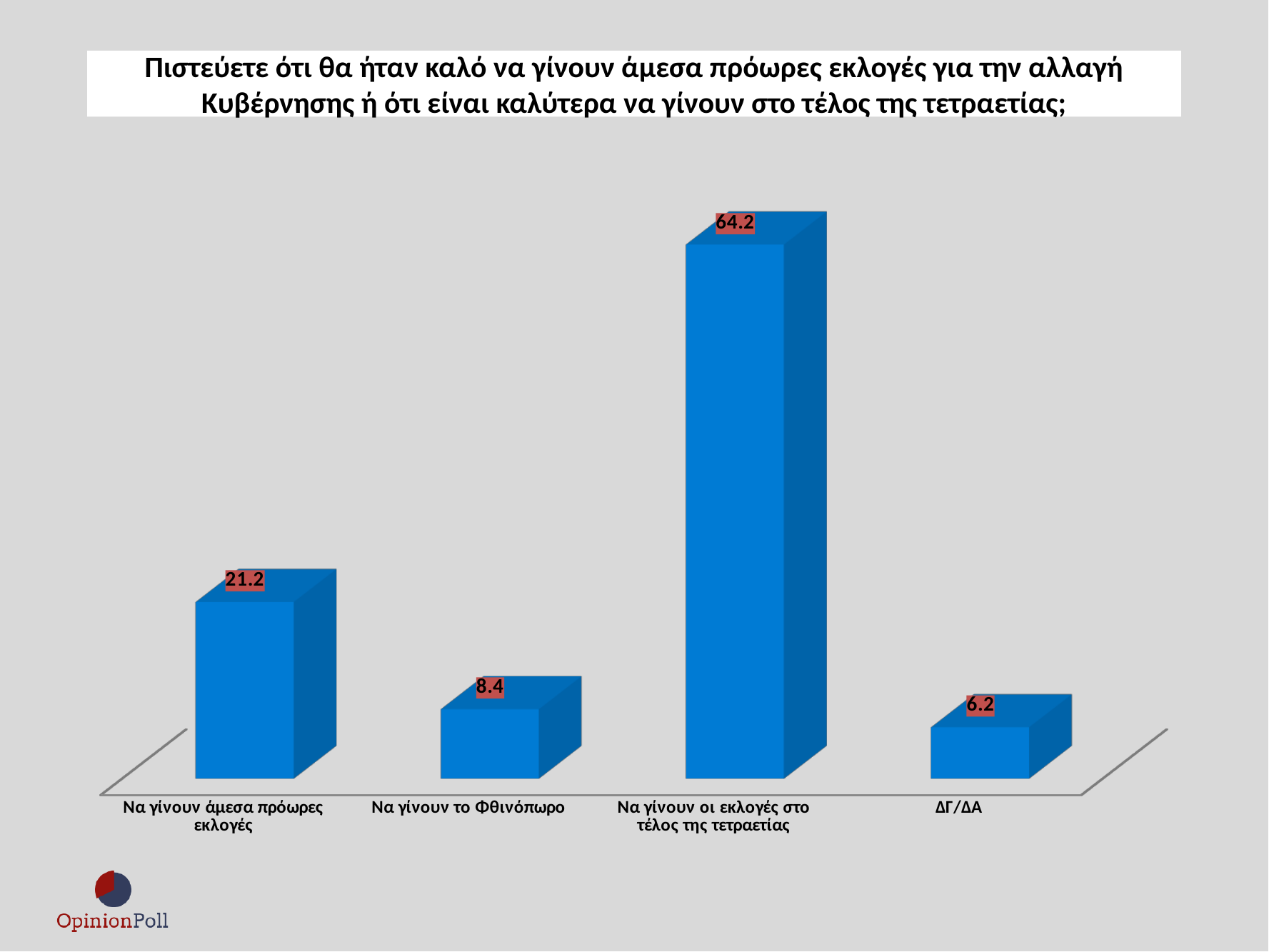
How many categories are shown in the chart? 4 What kind of chart is shown on the slide? Bar chart What colour are the bars in the chart? Blue What is the value for "ΔΓ/ΔΑ"? 6.2 What is the value for "Να γίνουν άμεσα πρόωρες εκλογές"? 21.2 Which category has the lowest value? ΔΓ/ΔΑ Which is larger, the value for "Να γίνουν άμεσα πρόωρες εκλογές" or the value for "Να γίνουν το Φθινόπωρο"? Να γίνουν άμεσα πρόωρες εκλογές What is the value for "Να γίνουν το Φθινόπωρο"? 8.4 What is the value for "Να γίνουν οι εκλογές στο τέλος της τετραετίας"? 64.2 What is the difference between the values for "Να γίνουν οι εκλογές στο τέλος της τετραετίας" and "Να γίνουν άμεσα πρόωρες εκλογές"? 43.0 Which category has the highest value? Να γίνουν οι εκλογές στο τέλος της τετραετίας What is the difference between the values for "Να γίνουν το Φθινόπωρο" and "ΔΓ/ΔΑ"? 2.2